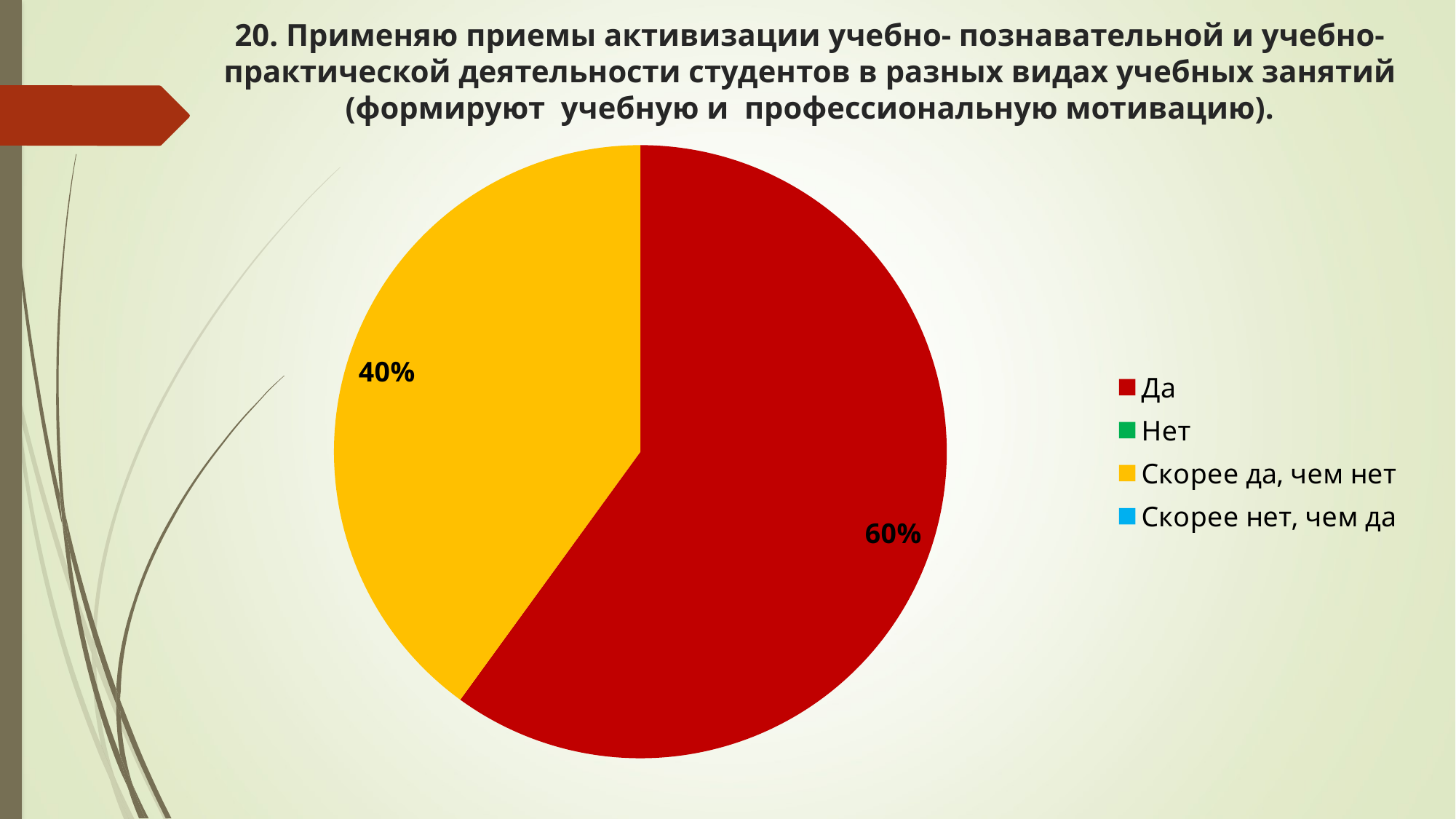
What share of the pie does "Скорее да, чем нет" have? 40% What colour is the "Скорее да, чем нет" slice? yellow What is the difference in percentage points between the "Да" slice and the "Скорее да, чем нет" slice? 20% Is the share for "Да" greater or less than 50%? greater What colour is the "Да" slice? red Which category has the largest slice of the pie? Да Which of the two visible slices is larger, "Да" or "Скорее да, чем нет"? Да What kind of chart is shown on the slide? pie chart How many entries does the legend list? 4 What share of the pie does "Да" have? 60% How many slices are visible in the pie? 2